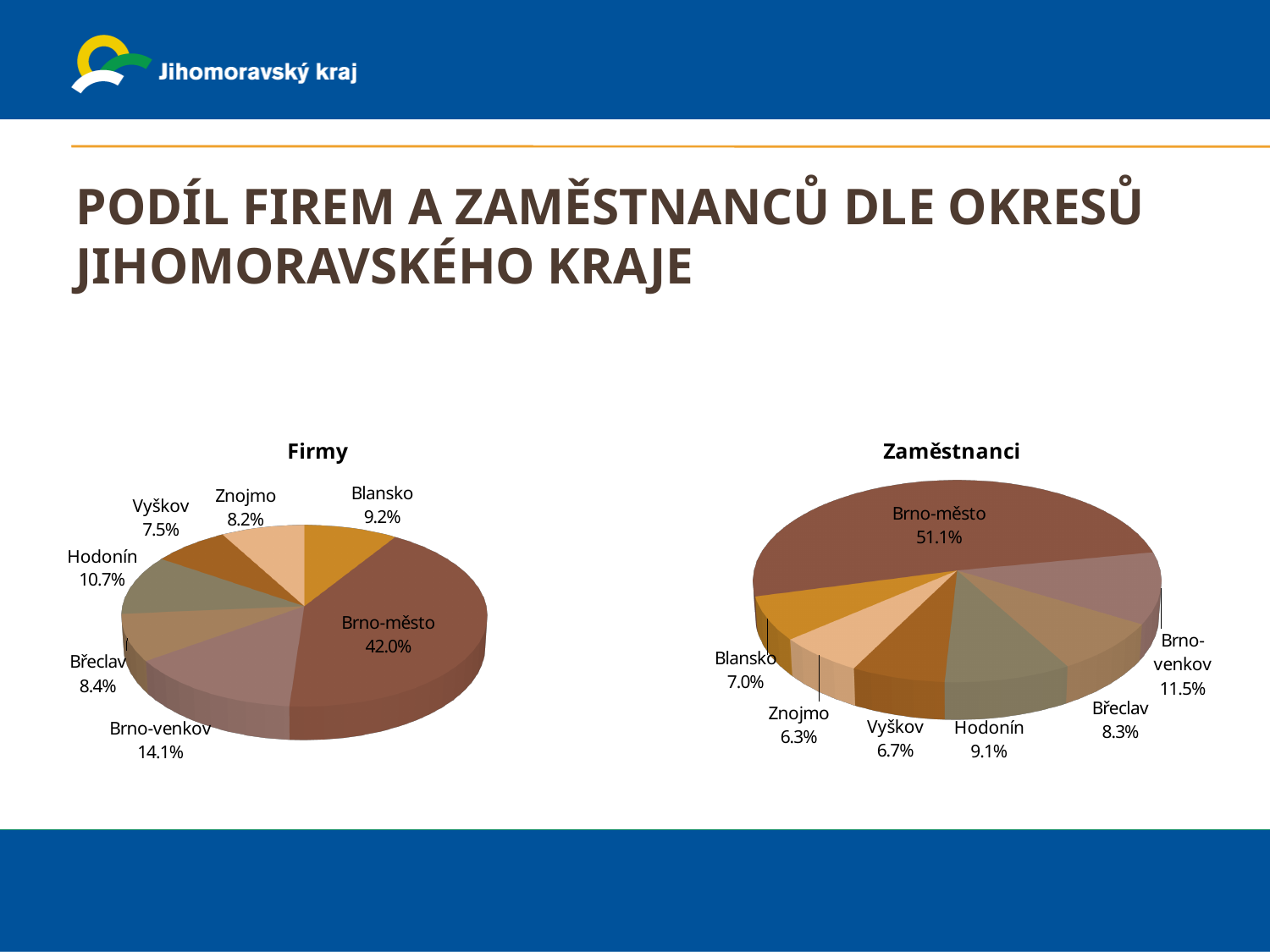
In the "Firmy" pie chart, which district has the smallest share? Vyškov What is the difference between Brno-město's share in the "Zaměstnanci" chart and its share in the "Firmy" chart? 9.1% In the "Firmy" pie chart, what share does Brno-město have? 42.0% What is the title of the pie chart on the left side of the slide? Firmy In the "Zaměstnanci" pie chart, which district has the largest share? Brno-město In the "Zaměstnanci" pie chart, what share does Brno-venkov have? 11.5% In the "Firmy" pie chart, what is the difference between the shares of Brno-venkov and Hodonín? 3.4% What kind of chart is the "Zaměstnanci" chart? Pie chart In the "Firmy" pie chart, what share does Blansko have? 9.2% How many districts are shown in the "Firmy" pie chart? 7 In the "Zaměstnanci" pie chart, which is larger: the share of Hodonín or the share of Břeclav? Hodonín In the "Zaměstnanci" pie chart, which district has the smallest share? Znojmo